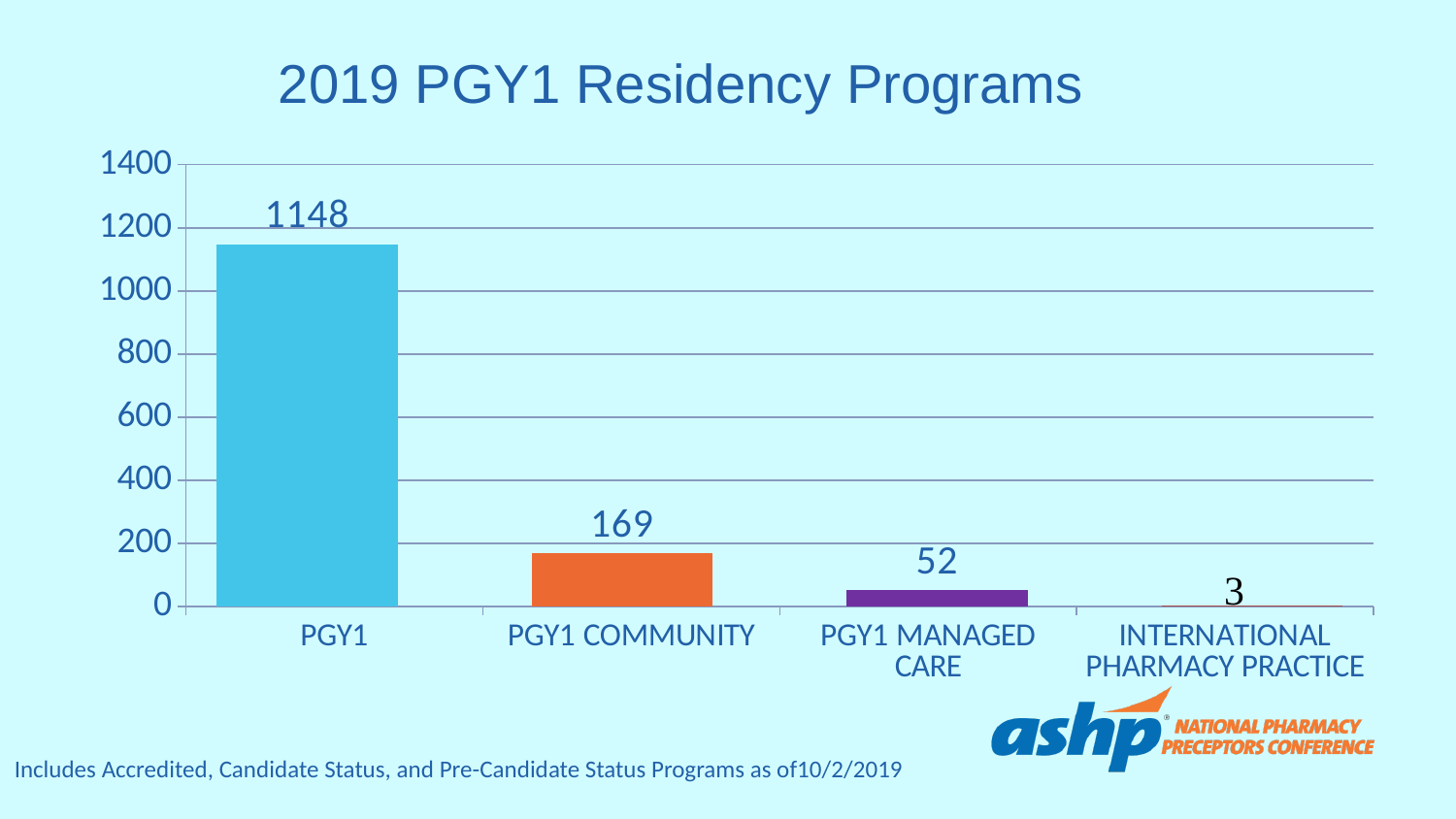
Which is larger, the value for PGY1 COMMUNITY or the value for PGY1 MANAGED CARE? PGY1 COMMUNITY What is the difference between the values for PGY1 COMMUNITY and PGY1 MANAGED CARE? 117 What is the title of the chart? 2019 PGY1 Residency Programs What kind of chart is shown on the slide? bar chart How many categories are shown on the x axis? 4 What is the value for PGY1 COMMUNITY? 169 What is the value for PGY1 MANAGED CARE? 52 What is the difference between the values for PGY1 and PGY1 COMMUNITY? 979 Which category has the lowest value? INTERNATIONAL PHARMACY PRACTICE What is the value for INTERNATIONAL PHARMACY PRACTICE? 3 Which category has the highest value? PGY1 What is the value for PGY1? 1148